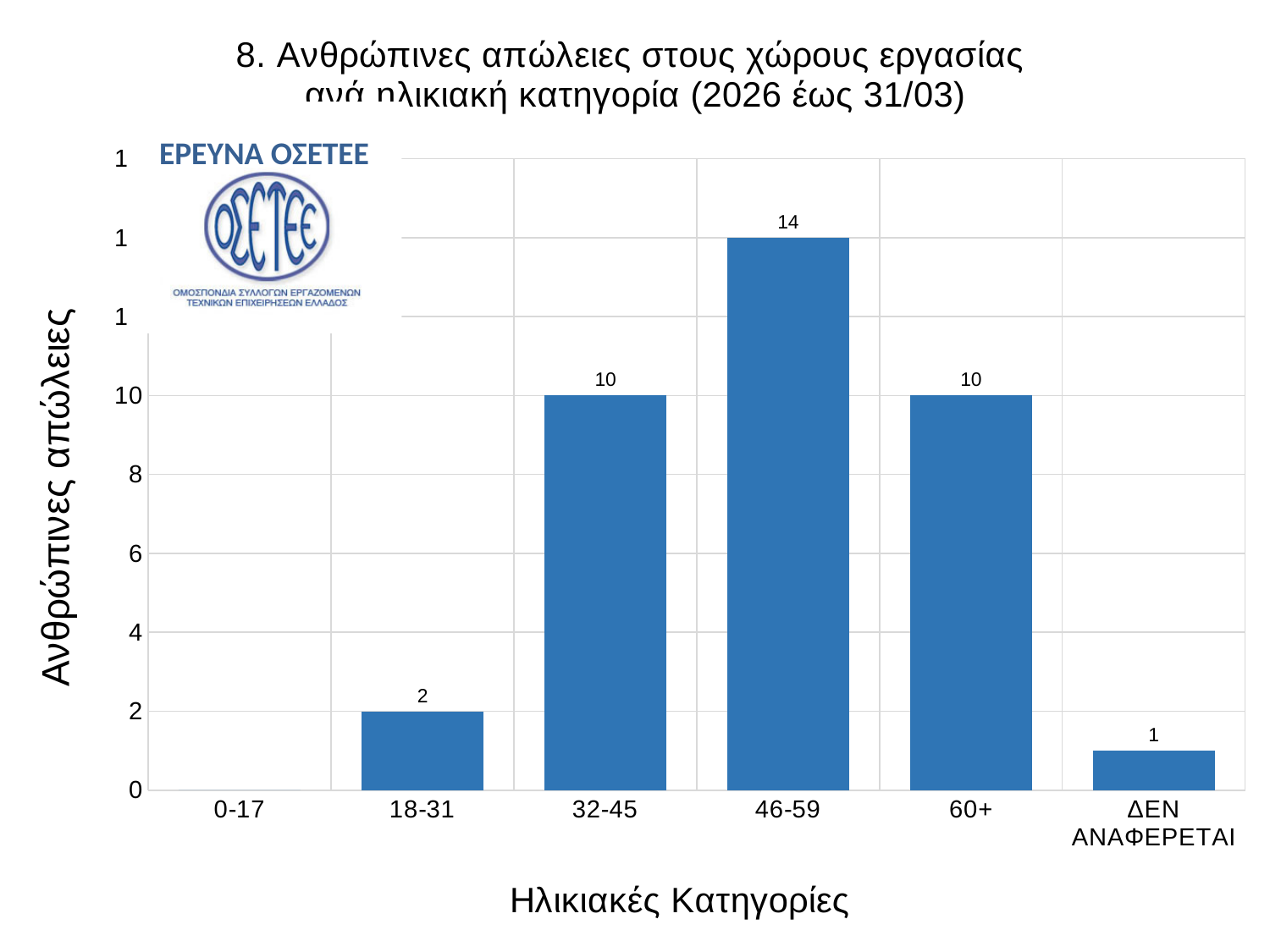
What is the value for the 46-59 age category? 14 What is the value for the 32-45 age category? 10 What is the difference between the values for 46-59 and 60+? 4 What is the difference between the values for 18-31 and ΔΕΝ ΑΝΑΦΕΡΕΤΑΙ? 1 What type of chart is shown on the slide? bar chart Which age category has the highest number of losses? 46-59 What is the title of the x axis? Ηλικιακές Κατηγορίες Which is larger, the value for 18-31 or the value for 60+? 60+ What is the title of the y axis? Ανθρώπινες απώλειες How many age categories are shown on the x axis? 6 What is the value for the 18-31 age category? 2 What is the value for the ΔΕΝ ΑΝΑΦΕΡΕΤΑΙ category? 1